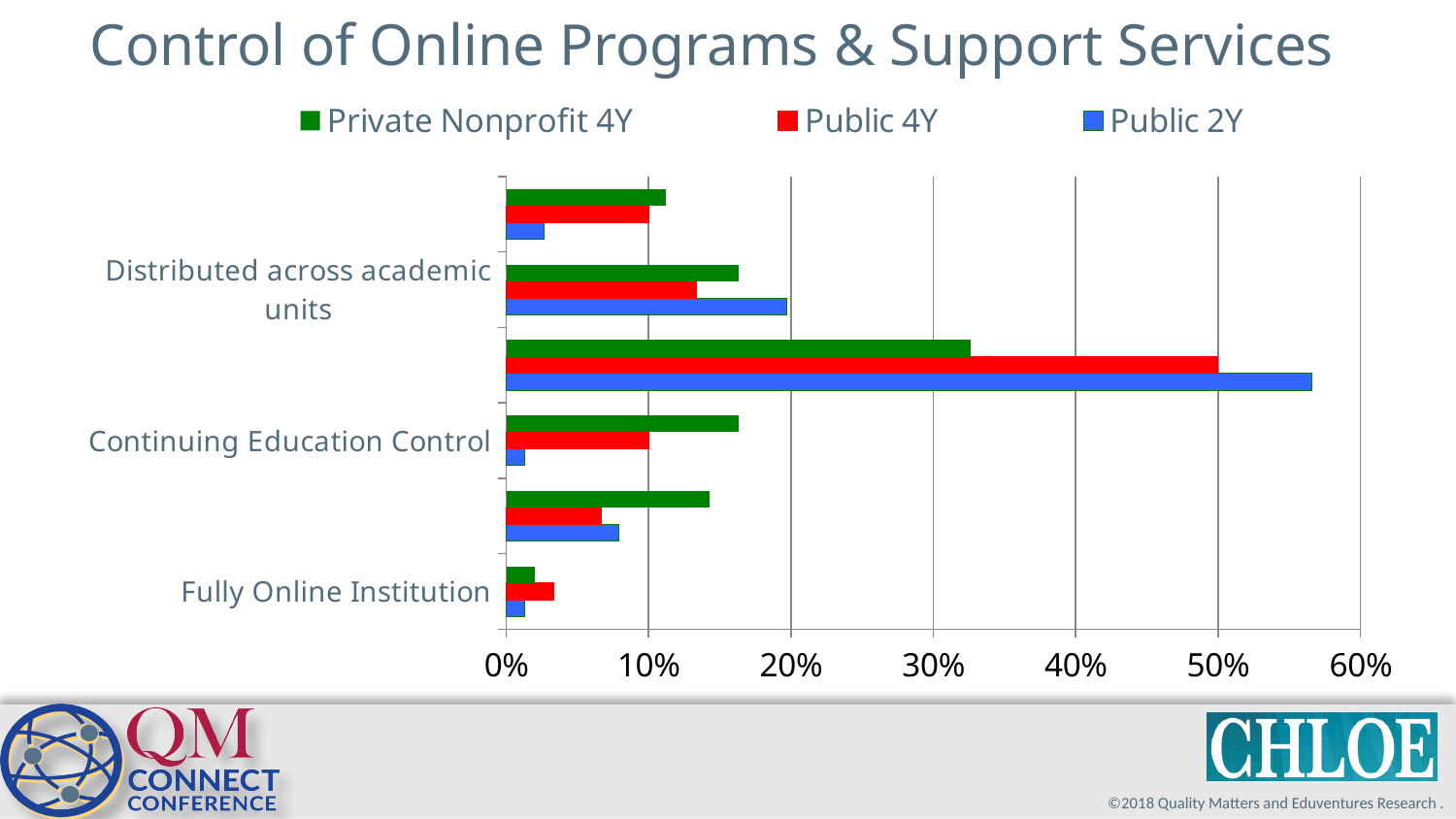
How many series does the legend list? 3 What kind of chart is shown on the slide? bar chart Under Continuing Education Control, which is larger: Private Nonprofit 4Y or Public 2Y? Private Nonprofit 4Y Under Fully Online Institution, which is larger: Public 4Y or Public 2Y? Public 4Y Is the value for Public 2Y under Distributed across academic units greater or less than 10%? greater Under Distributed across academic units, which is larger: Public 2Y or Public 4Y? Public 2Y Is the value for Public 4Y under Fully Online Institution greater or less than 10%? less Which series has the highest value under Continuing Education Control? Private Nonprofit 4Y Is the value for Private Nonprofit 4Y under Continuing Education Control greater or less than 10%? greater Which series has the lowest value under Continuing Education Control? Public 2Y What is the title of the chart? Control of Online Programs & Support Services Which series is shown in red in the legend? Public 4Y